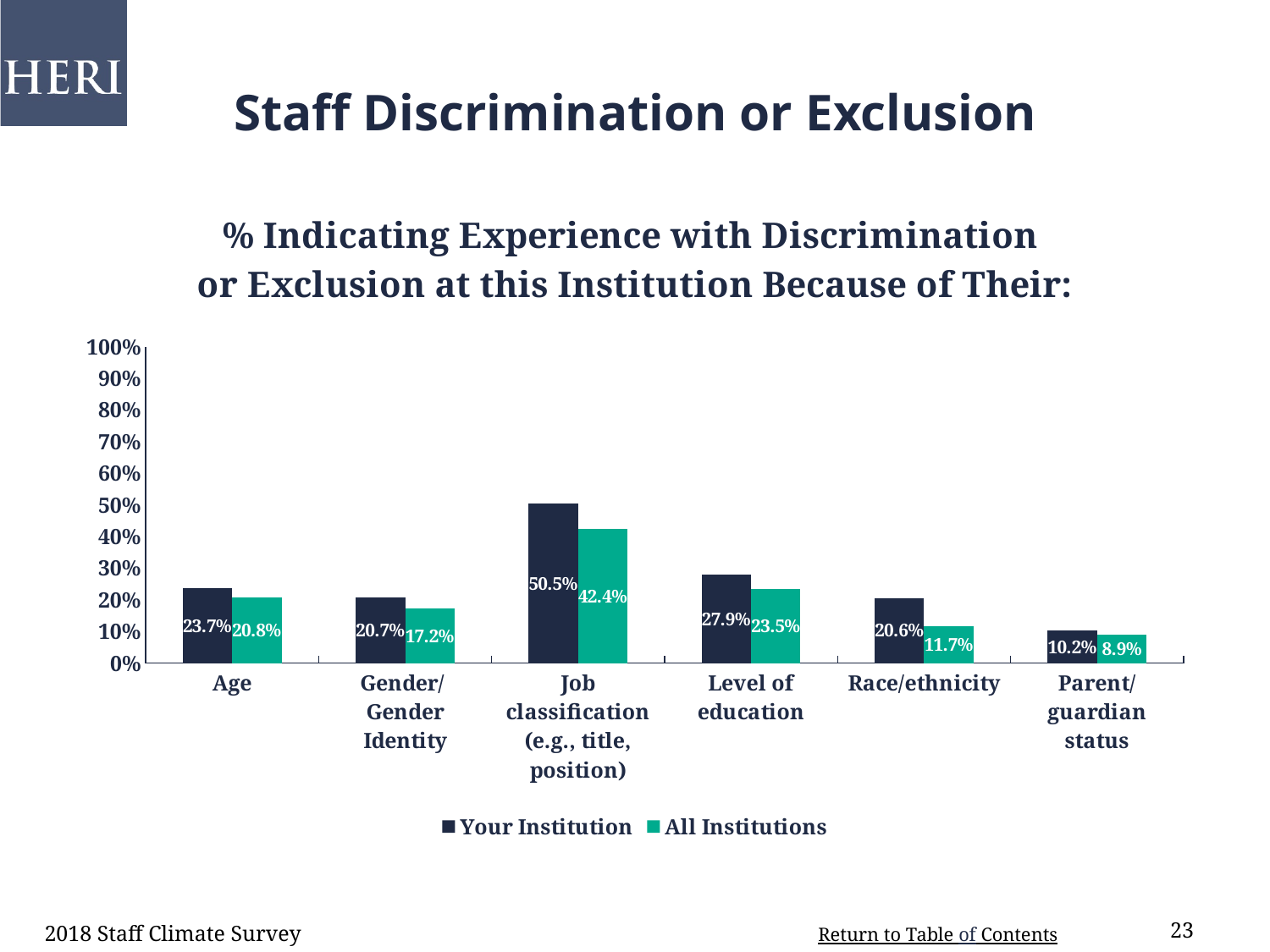
Which category has the lowest value for Your Institution? Parent/guardian status How many series does the legend list? 2 Which category has the highest value for All Institutions? Job classification (e.g., title, position) What kind of chart is shown on the slide? Bar chart Which is larger for Level of education: Your Institution or All Institutions? Your Institution How many categories are shown on the x axis? 6 What is the difference between Your Institution and All Institutions for Race/ethnicity? 8.9% What is the value for All Institutions for Race/ethnicity? 11.7% What is the value for Your Institution for Parent/guardian status? 10.2% What is the difference between Your Institution and All Institutions for Job classification (e.g., title, position)? 8.1% What is the value for Your Institution for Job classification (e.g., title, position)? 50.5% What colour are the bars for All Institutions? Green